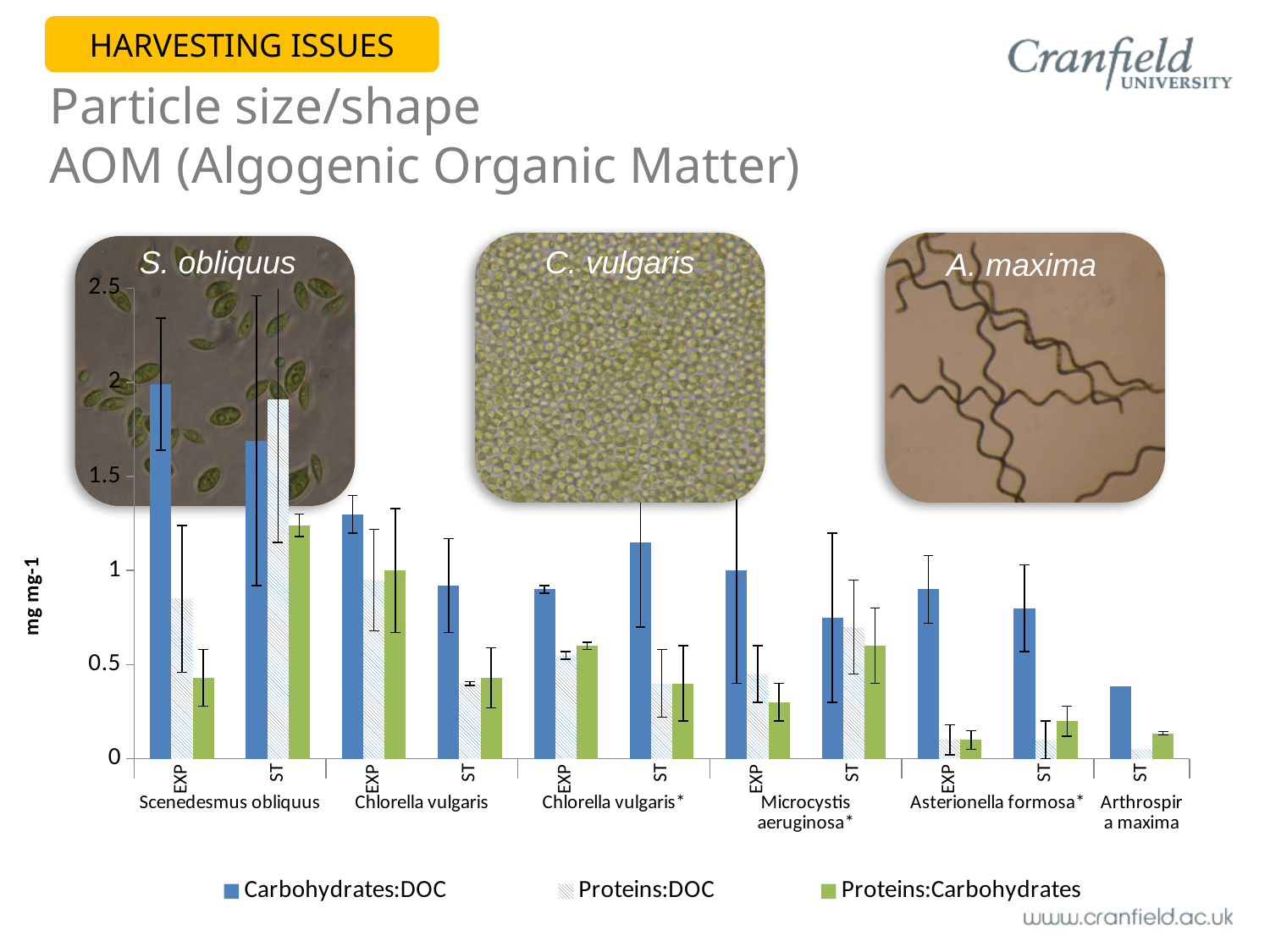
Which bar group has the lowest Carbohydrates:DOC value? Arthrospira maxima ST Is the Carbohydrates:DOC value for Scenedesmus obliquus EXP greater or less than 1.5? greater Is the Carbohydrates:DOC value for Chlorella vulgaris EXP greater or less than 1? greater For Scenedesmus obliquus EXP, which is larger: the Carbohydrates:DOC value or the Proteins:Carbohydrates value? Carbohydrates:DOC Which bar group has the highest Carbohydrates:DOC value? Scenedesmus obliquus EXP How many series does the chart's legend list? 3 What is the label on the vertical axis of the chart? mg mg-1 Is the Proteins:Carbohydrates value for Asterionella formosa* EXP greater or less than 0.5? less What kind of chart is shown on the slide? bar chart How many EXP/ST bar groups are plotted along the x axis? 11 What are the three series named in the legend? Carbohydrates:DOC, Proteins:DOC, Proteins:Carbohydrates